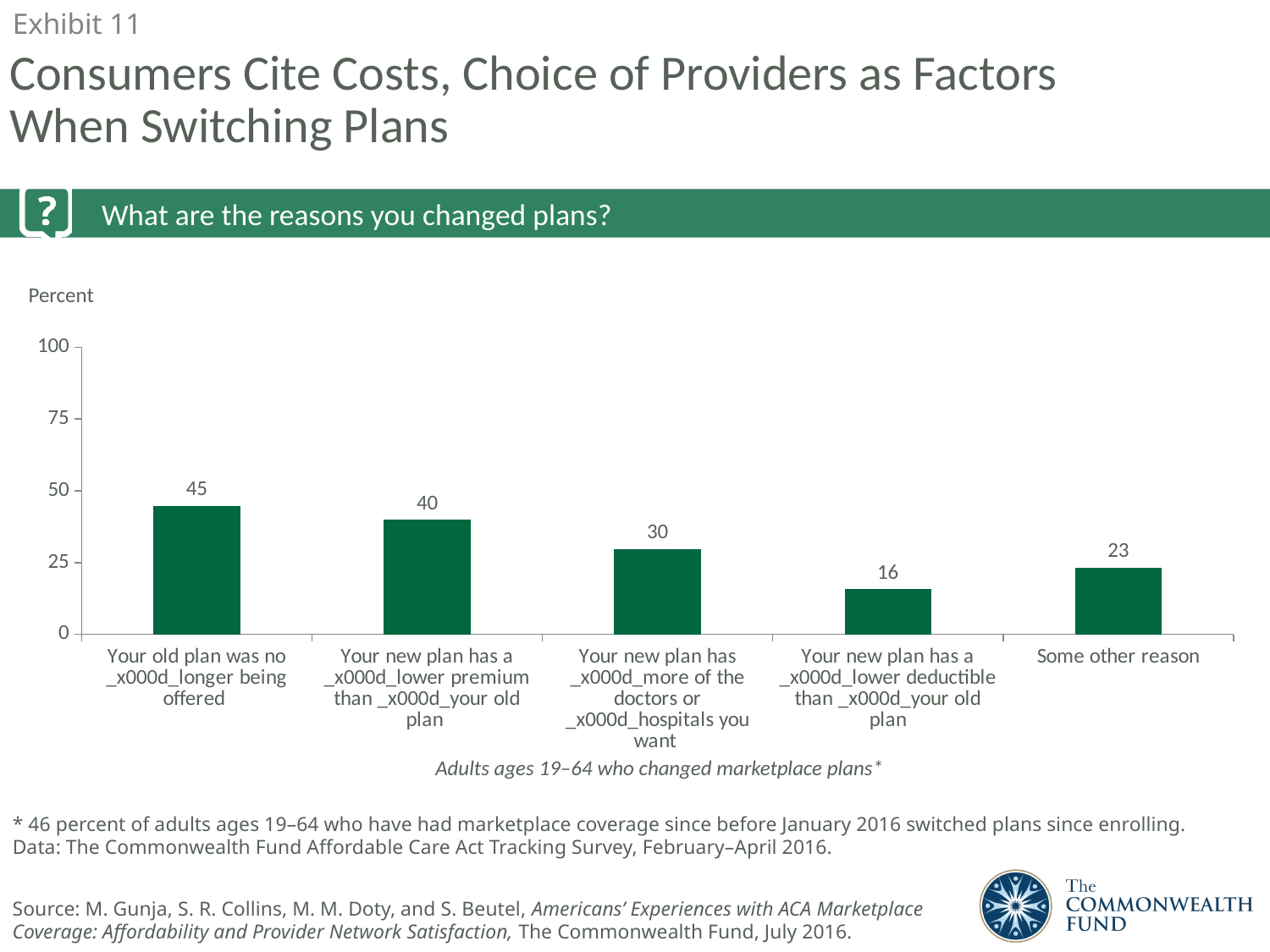
What is the value for 'Your new plan has a lower premium than your old plan'? 40 What is the difference between the percentage citing the old plan no longer being offered and the percentage citing a lower deductible? 29 What percentage of adults cited that their old plan was no longer being offered as a reason for changing plans? 45 What is the value for 'Some other reason'? 23 Which reason for changing plans has the lowest percentage? Your new plan has a lower deductible than your old plan Which reason for changing plans has the highest percentage? Your old plan was no longer being offered What is the maximum value shown on the vertical axis of the chart? 100 Is the value for 'Your new plan has a lower deductible than your old plan' greater or less than 25? less What type of chart is used on this slide? bar chart Which is larger: the value for 'Your new plan has a lower premium than your old plan' or the value for 'Some other reason'? Your new plan has a lower premium than your old plan What percentage cited that their new plan has more of the doctors or hospitals they want? 30 How many reasons for changing plans are shown in the chart? 5